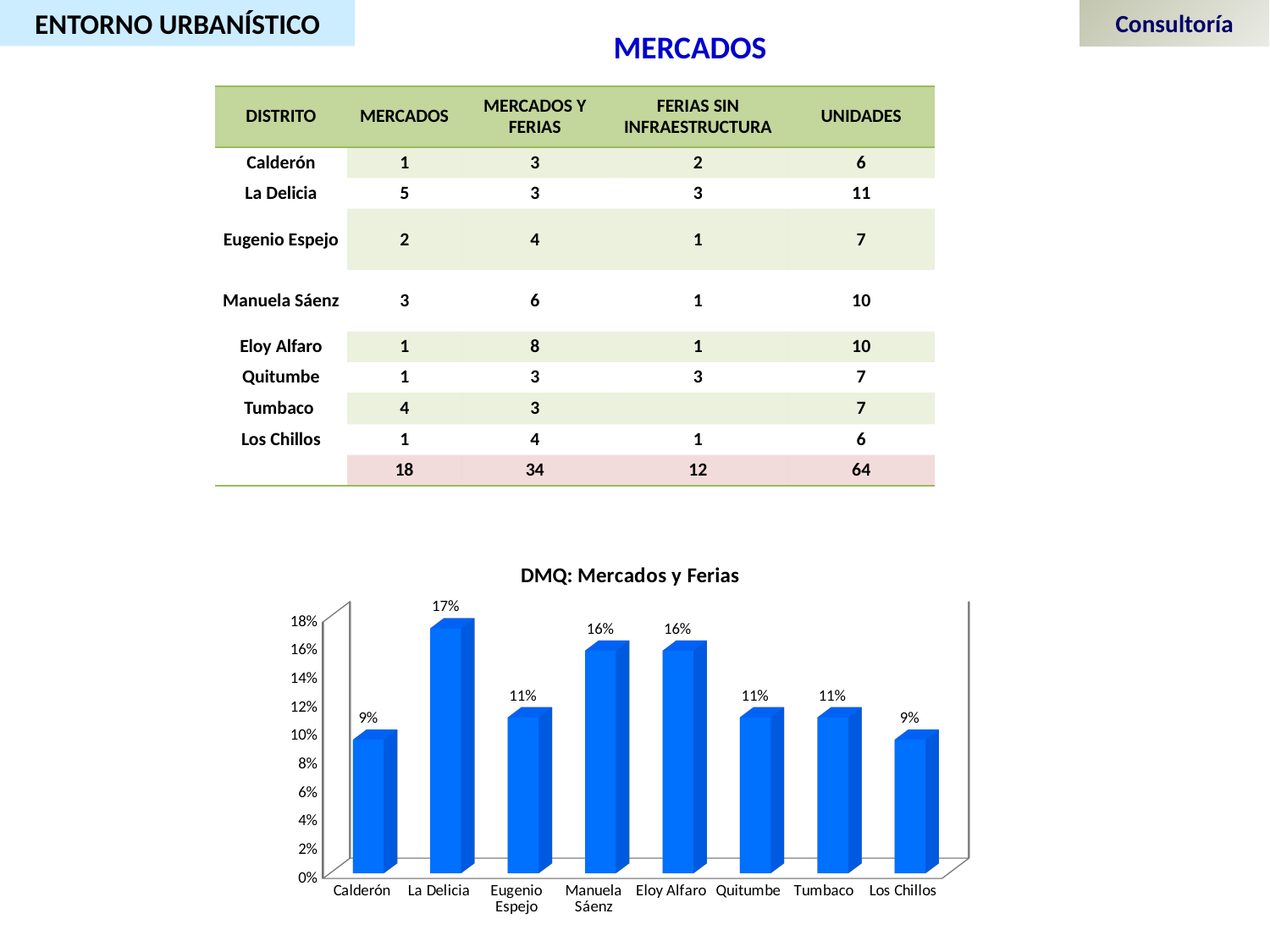
What is the value for Manuela Sáenz in the DMQ: Mercados y Ferias chart? 16% What is the difference between the values for Eloy Alfaro and Quitumbe in the DMQ: Mercados y Ferias chart? 5 percentage points Which district has the highest value in the DMQ: Mercados y Ferias chart? La Delicia What is the value for Tumbaco in the DMQ: Mercados y Ferias chart? 11% How many districts are shown in the DMQ: Mercados y Ferias chart? 8 What is the value for La Delicia in the DMQ: Mercados y Ferias chart? 17% What is the difference between the values for La Delicia and Calderón in the DMQ: Mercados y Ferias chart? 8 percentage points What is the title of the chart on the slide? DMQ: Mercados y Ferias What is the value for Calderón in the DMQ: Mercados y Ferias chart? 9% In the DMQ: Mercados y Ferias chart, which is larger, the value for Eugenio Espejo or the value for Manuela Sáenz? Manuela Sáenz What kind of chart is DMQ: Mercados y Ferias? bar chart In the DMQ: Mercados y Ferias chart, is the value for Los Chillos greater or less than 10%? less